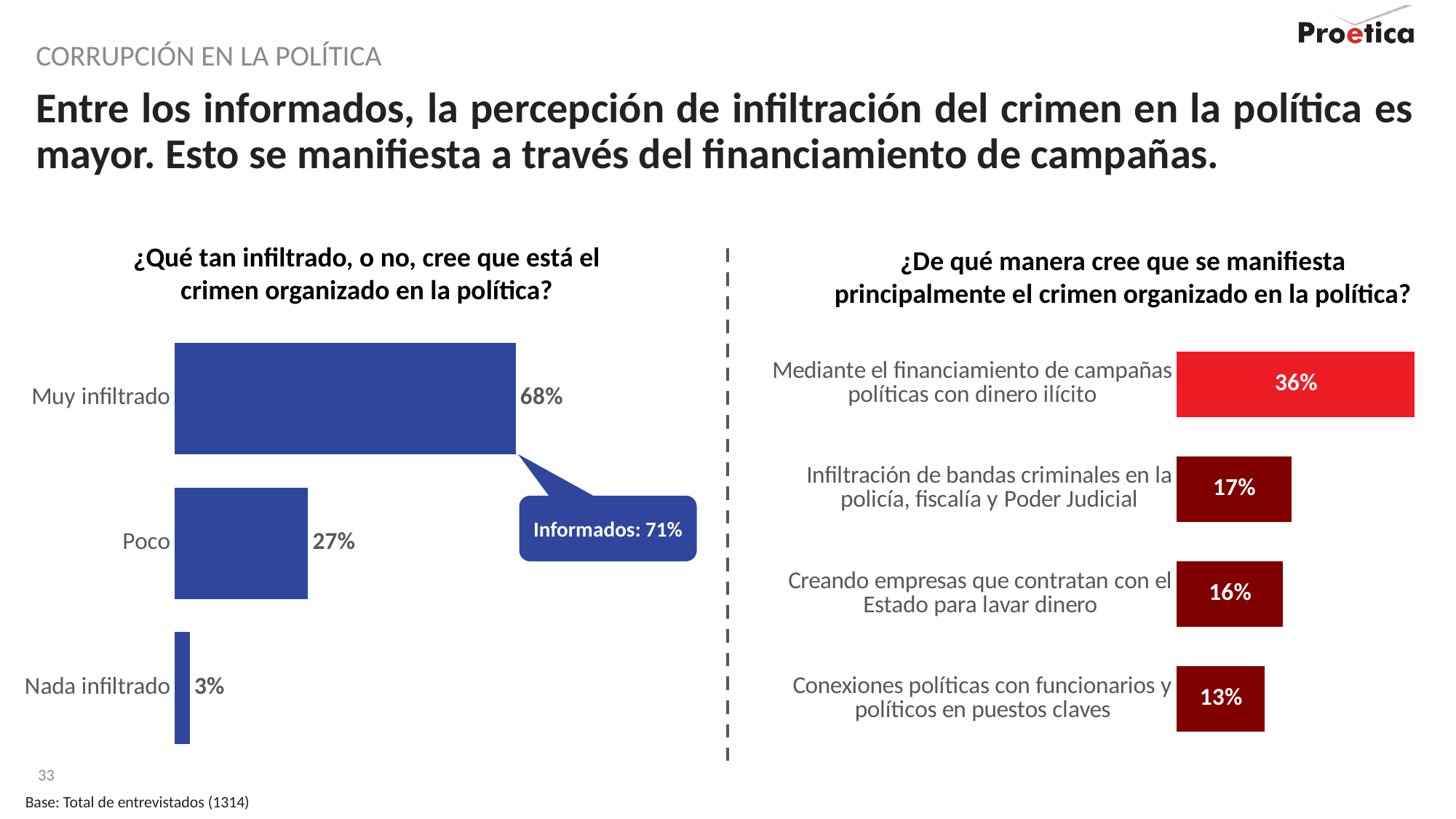
In the right chart (¿De qué manera cree que se manifiesta principalmente el crimen organizado en la política?), what is the value for 'Mediante el financiamiento de campañas políticas con dinero ilícito'? 36% In the left chart (¿Qué tan infiltrado, o no, cree que está el crimen organizado en la política?), what is the value for Muy infiltrado? 68% In the right chart (¿De qué manera cree que se manifiesta principalmente el crimen organizado en la política?), which is larger: 'Infiltración de bandas criminales en la policía, fiscalía y Poder Judicial' or 'Creando empresas que contratan con el Estado para lavar dinero'? Infiltración de bandas criminales en la policía, fiscalía y Poder Judicial What type of chart is the right chart (¿De qué manera cree que se manifiesta principalmente el crimen organizado en la política?)? Bar chart In the left chart (¿Qué tan infiltrado, o no, cree que está el crimen organizado en la política?), what is the value for Poco? 27% In the right chart (¿De qué manera cree que se manifiesta principalmente el crimen organizado en la política?), what is the difference between the highest and lowest values? 23 percentage points In the left chart (¿Qué tan infiltrado, o no, cree que está el crimen organizado en la política?), what value does the callout give for Informados? 71% In the left chart (¿Qué tan infiltrado, o no, cree que está el crimen organizado en la política?), how many categories are shown? 3 In the left chart (¿Qué tan infiltrado, o no, cree que está el crimen organizado en la política?), which category has the lowest value? Nada infiltrado In the right chart (¿De qué manera cree que se manifiesta principalmente el crimen organizado en la política?), which category has the highest value? Mediante el financiamiento de campañas políticas con dinero ilícito In the left chart (¿Qué tan infiltrado, o no, cree que está el crimen organizado en la política?), what is the difference between Muy infiltrado and Poco? 41 percentage points In the right chart (¿De qué manera cree que se manifiesta principalmente el crimen organizado en la política?), what is the value for 'Conexiones políticas con funcionarios y políticos en puestos claves'? 13%